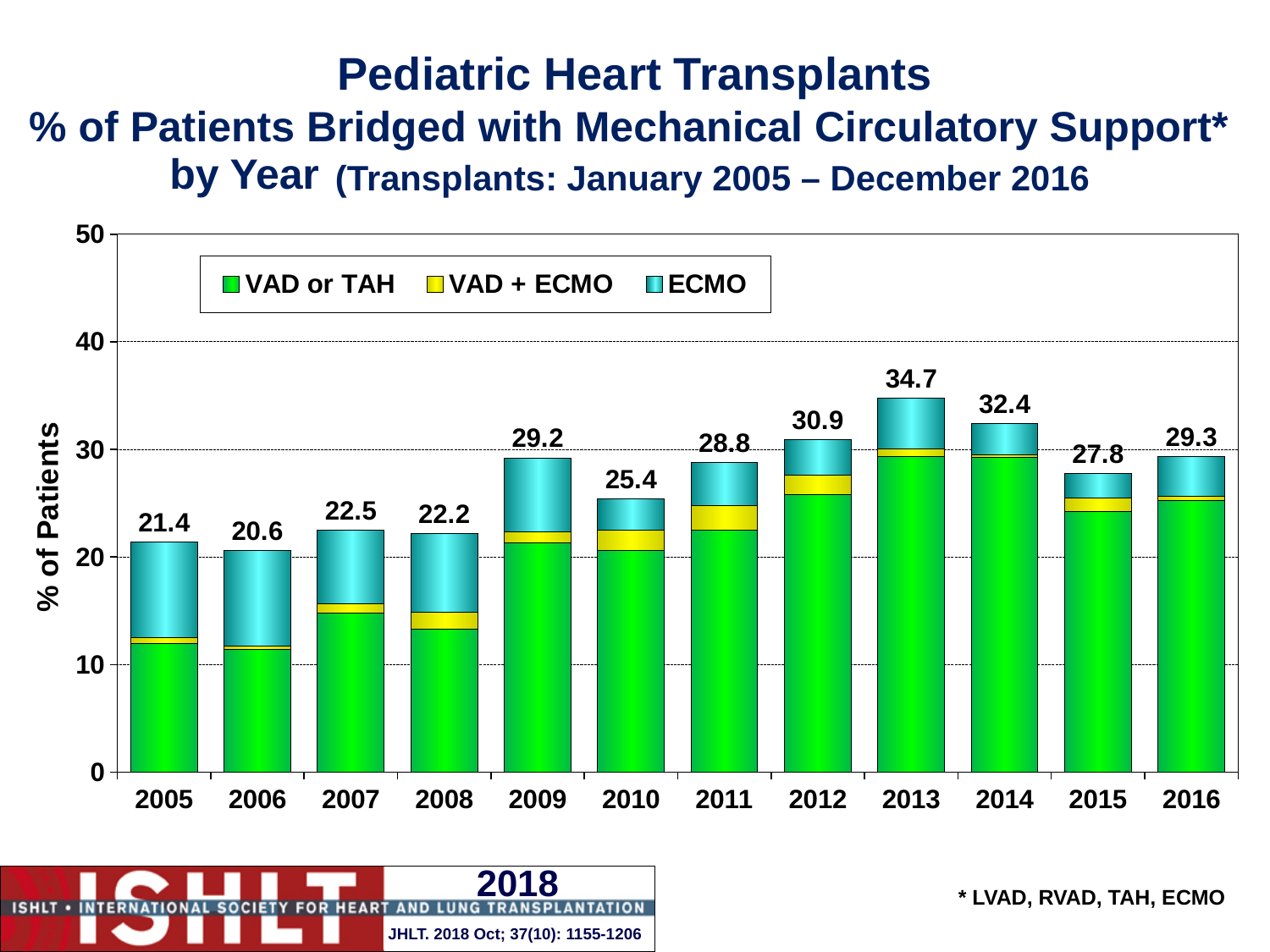
Is the VAD or TAH segment for 2013 greater or less than 20? greater How many years are shown on the x axis? 12 What is the total value shown for 2016? 29.3 What is the total percentage of patients bridged with mechanical circulatory support in 2013? 34.7 How many series does the legend list? 3 Which series is shown in green in the legend? VAD or TAH What is the difference between the total for 2013 and the total for 2006? 14.1 What is the total value shown for 2005? 21.4 Which year has the lowest total percentage of patients bridged with mechanical circulatory support? 2006 Which year has the highest total percentage of patients bridged with mechanical circulatory support? 2013 Which year has a larger total, 2012 or 2015? 2012 What kind of chart is shown on the slide? Stacked bar chart